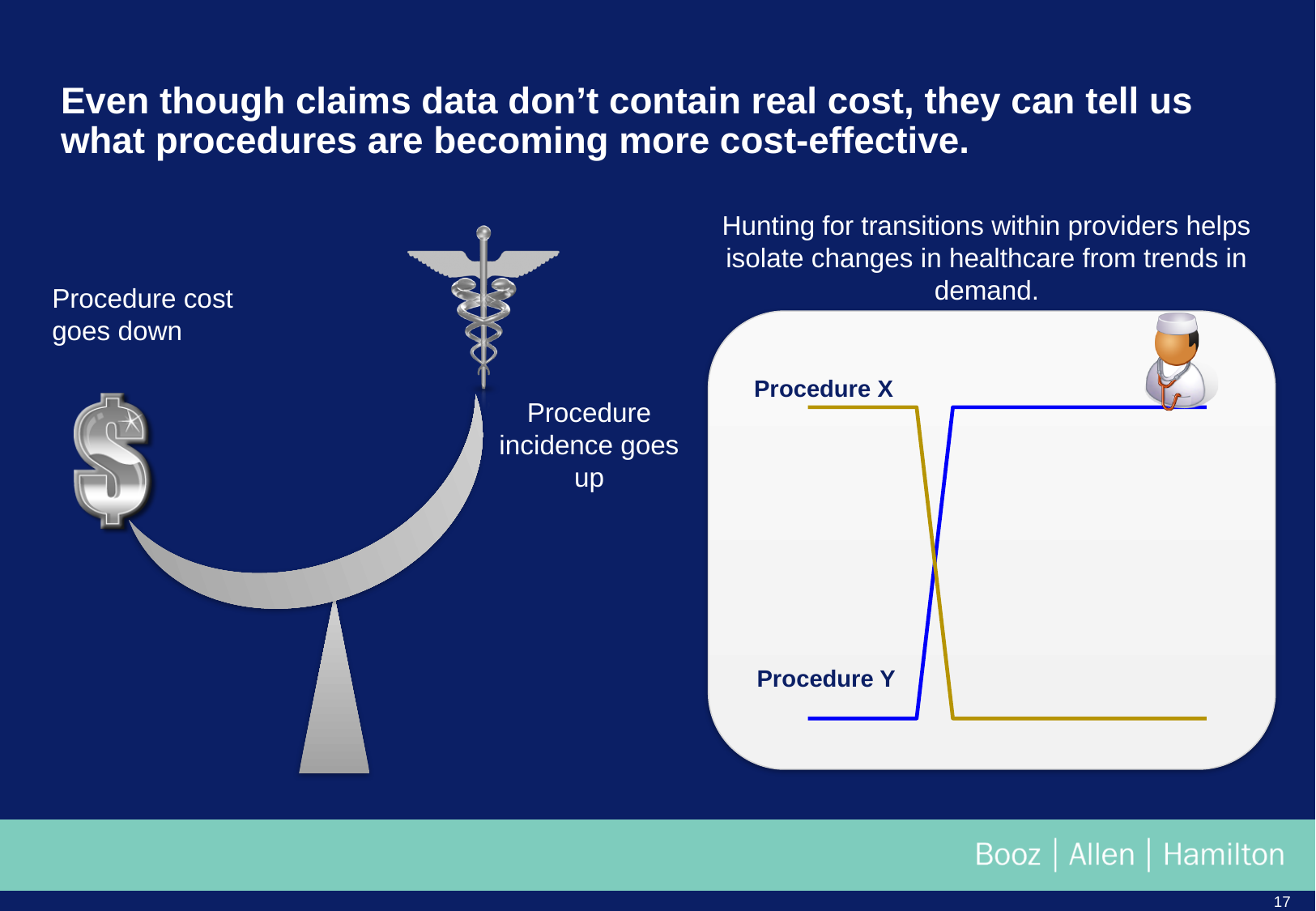
How many lines (series) are plotted in the chart on the right? 2 In the chart on the right, which procedure's line starts high and ends low? Procedure X In the chart on the right, which procedure's line is higher at the right end of the chart? Procedure Y In the chart on the right, which procedure's line is higher at the left end of the chart? Procedure X What kind of chart is shown in the box on the right of the slide? line chart What colour is the Procedure X line in the chart on the right? gold In the chart on the right, does the Procedure X line rise or fall from left to right? fall What colour is the Procedure Y line in the chart on the right? blue In the chart on the right, which procedure's line starts low and ends high? Procedure Y What are the names of the two series plotted in the chart on the right? Procedure X and Procedure Y